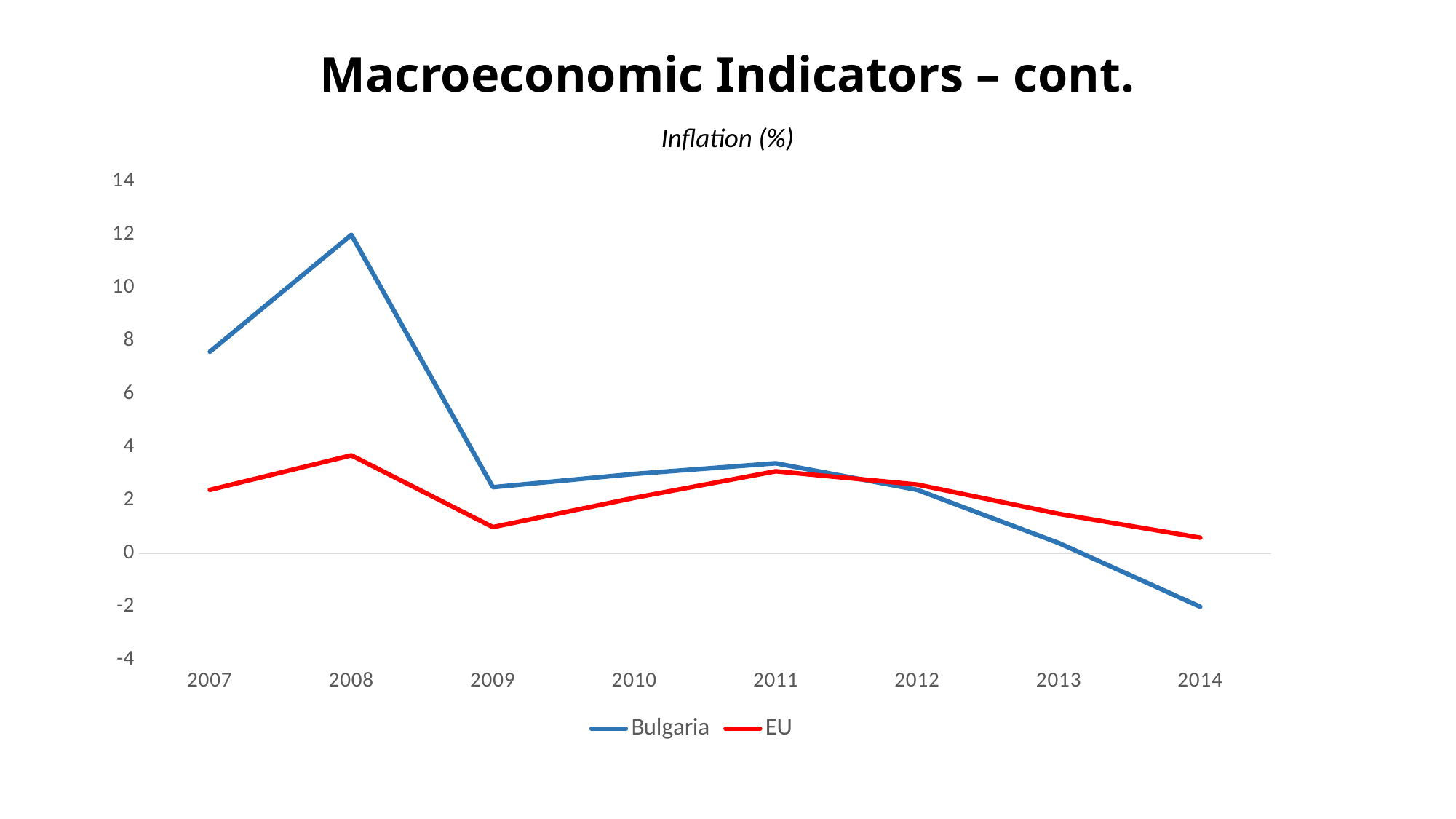
Is the EU's inflation in 2009 greater or less than 2? less Is Bulgaria's inflation in 2014 greater or less than 0? less How many series does the legend list? 2 In which year does Bulgaria's inflation reach its lowest value? 2014 Does Bulgaria's inflation rise or fall from 2011 to 2014? fall What kind of chart is shown on the slide? line chart In which year does the EU's inflation reach its highest value? 2008 In 2013, which series has the higher inflation, Bulgaria or EU? EU How many years are shown on the x axis? 8 In which year does Bulgaria's inflation reach its highest value? 2008 In 2008, which series has the higher inflation, Bulgaria or EU? Bulgaria Is Bulgaria's inflation in 2008 greater or less than 10? greater